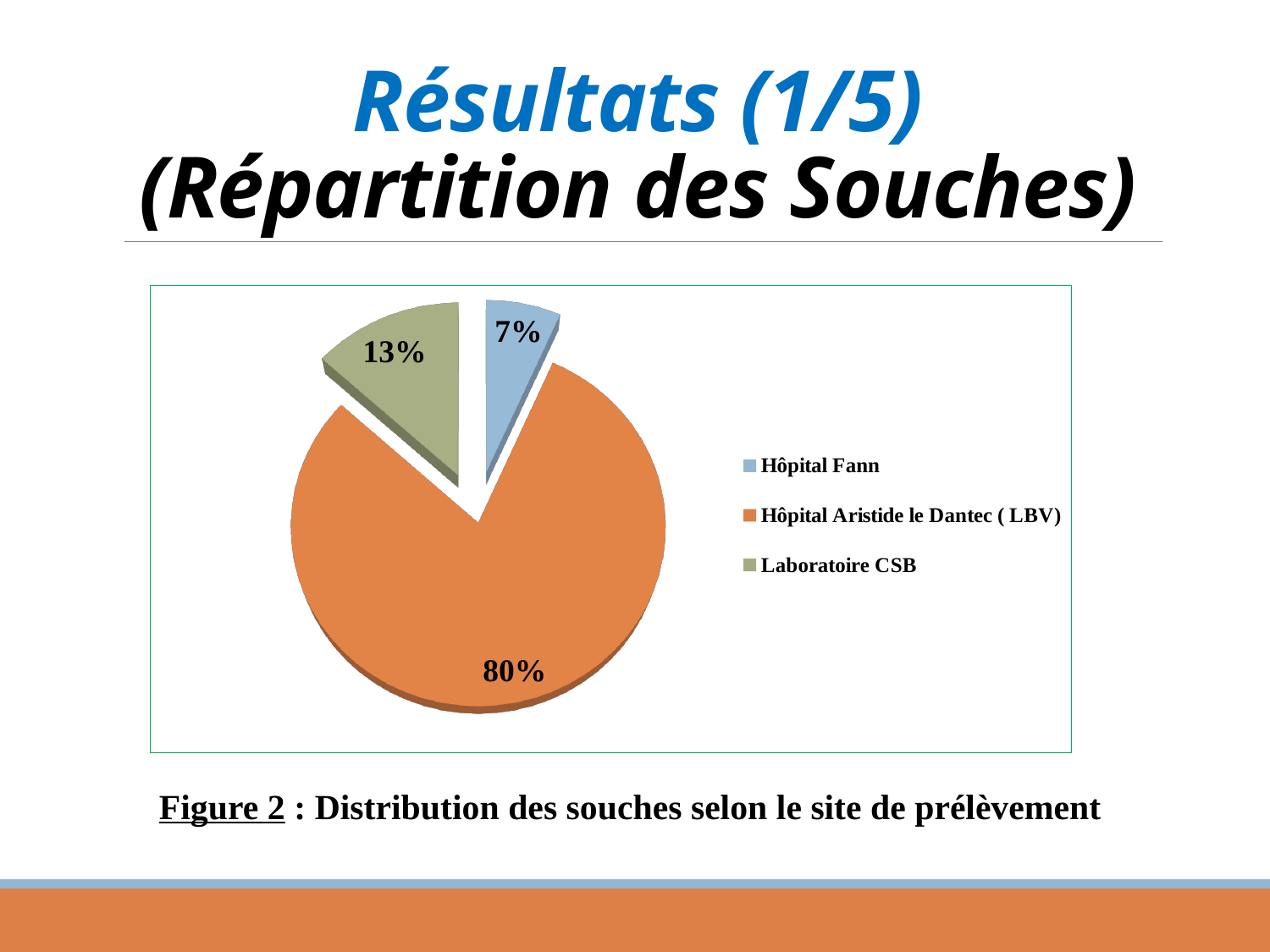
Which site has the largest share of strains? Hôpital Aristide le Dantec (LBV) What colour is the slice for Hôpital Aristide le Dantec (LBV)? Orange Which site has the smallest share of strains? Hôpital Fann What share of the pie does Laboratoire CSB account for? 13% What is the caption of the figure below the chart? Figure 2 : Distribution des souches selon le site de prélèvement What is the difference in percentage points between the Hôpital Aristide le Dantec (LBV) share and the Laboratoire CSB share? 67 Which is larger, the share for Laboratoire CSB or the share for Hôpital Fann? Laboratoire CSB What share of the pie does Hôpital Fann account for? 7% What is the difference in percentage points between the Laboratoire CSB share and the Hôpital Fann share? 6 What kind of chart is shown on the slide? Pie chart How many slices does the pie chart have? 3 What share of the pie does Hôpital Aristide le Dantec (LBV) account for? 80%